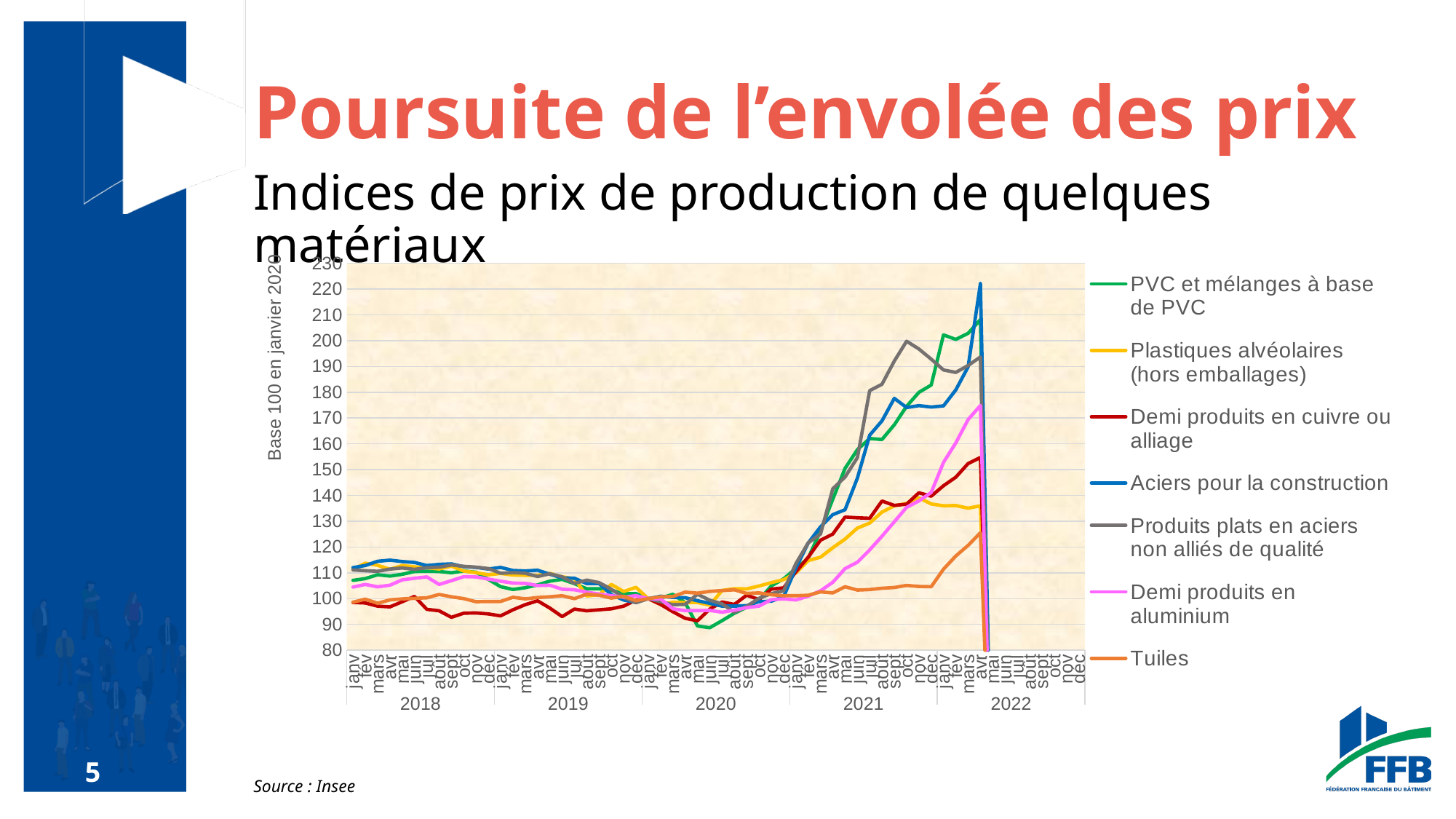
What is the source cited for the chart? Insee Is the value for Tuiles in April 2022 greater or less than 120? greater How many years are labelled along the x axis? 5 What kind of chart is shown on the slide? line chart How many series does the legend list? 7 Does the Tuiles series rise or fall from January 2021 to April 2022? rise Is the peak value for Plastiques alvéolaires (hors emballages) greater or less than 150? less Which series reaches the highest value on the chart? Aciers pour la construction Which series has the lowest value in early 2022? Tuiles Is the peak value for Aciers pour la construction greater or less than 210? greater Which series has the higher peak: Produits plats en aciers non alliés de qualité or Demi produits en aluminium? Produits plats en aciers non alliés de qualité What is the label of the vertical axis? Base 100 en janvier 2020